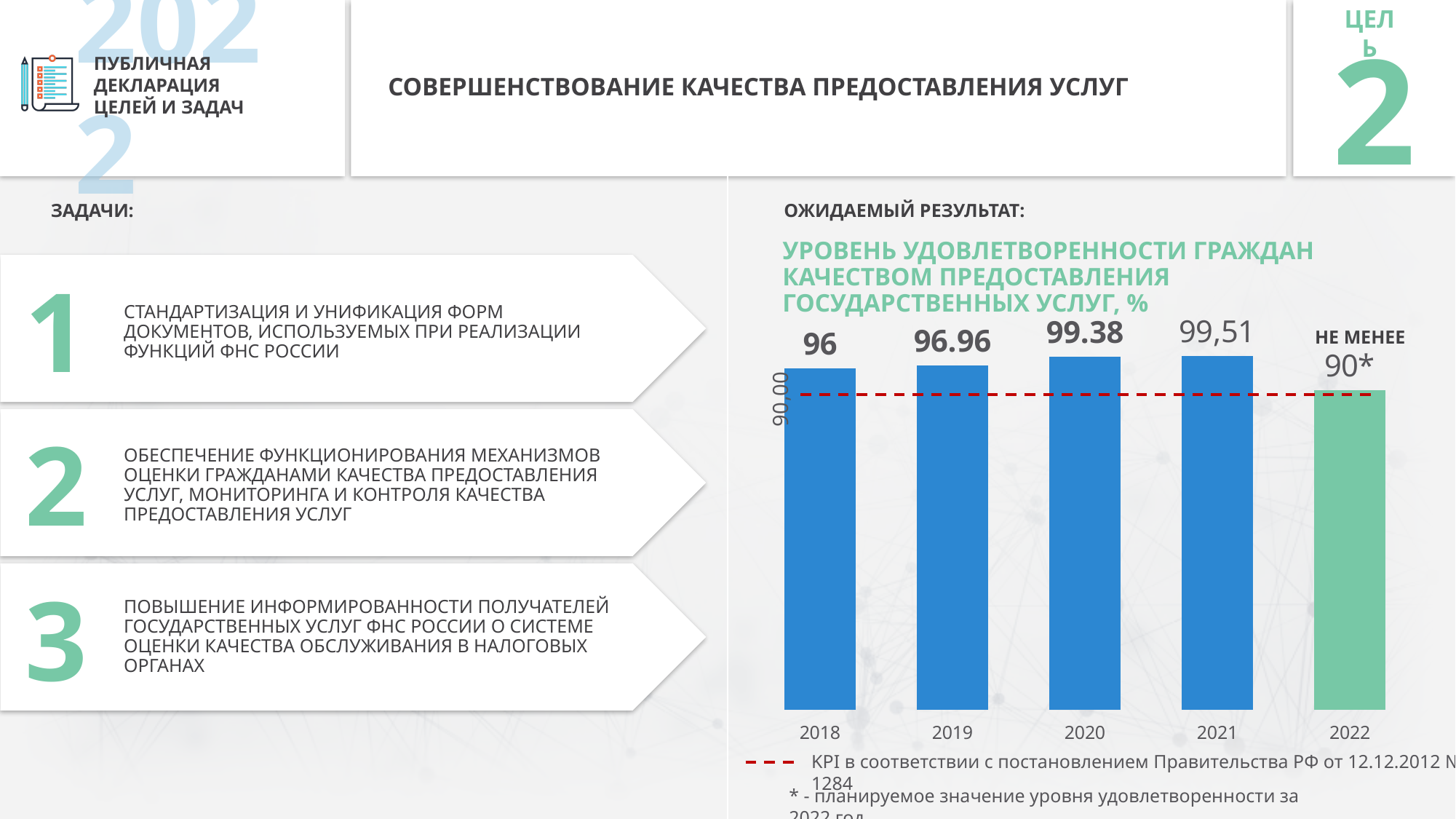
What is the value for 2018? 96 Do the values rise or fall from 2018 to 2021? rise What type of chart is shown on the slide? bar chart What is the value for 2019? 96.96 What is the difference between the values for 2020 and 2019? 2.42 What is the value for 2020? 99.38 Which year has the highest value? 2021 What is the value for 2021? 99,51 How many years are shown on the x axis? 5 Which year has the lowest bar? 2022 Which is larger, the value for 2018 or the value for 2020? 2020 What is the planned value shown for 2022? не менее 90*